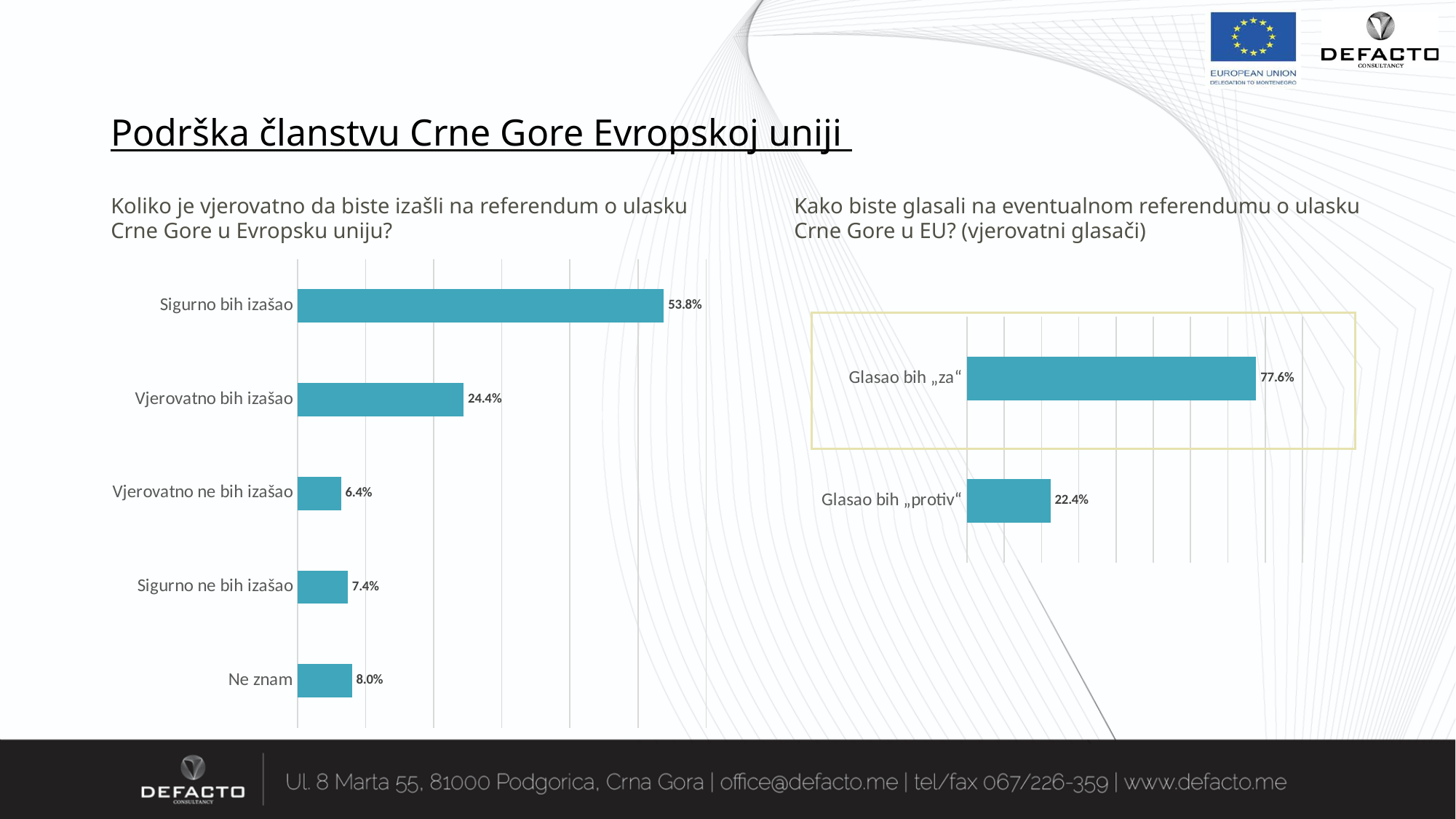
In the left chart, what is the difference between "Sigurno bih izašao" and "Vjerovatno bih izašao"? 29.4% In the right chart (Kako biste glasali na eventualnom referendumu...), what is the value for "Glasao bih „za“"? 77.6% In the left chart, what is the value for "Vjerovatno bih izašao"? 24.4% How many categories does the left chart show? 5 In the left chart, which is larger: "Sigurno ne bih izašao" or "Vjerovatno ne bih izašao"? Sigurno ne bih izašao What kind of chart is the right chart? Bar chart In the left chart, which category has the highest value? Sigurno bih izašao In the right chart, what is the value for "Glasao bih „protiv“"? 22.4% In the left chart, what is the value for "Ne znam"? 8.0% In the right chart, what is the difference between "Glasao bih „za“" and "Glasao bih „protiv“"? 55.2% In the left chart (Koliko je vjerovatno da biste izašli na referendum...), what is the value for "Sigurno bih izašao"? 53.8% In the left chart, which category has the lowest value? Vjerovatno ne bih izašao